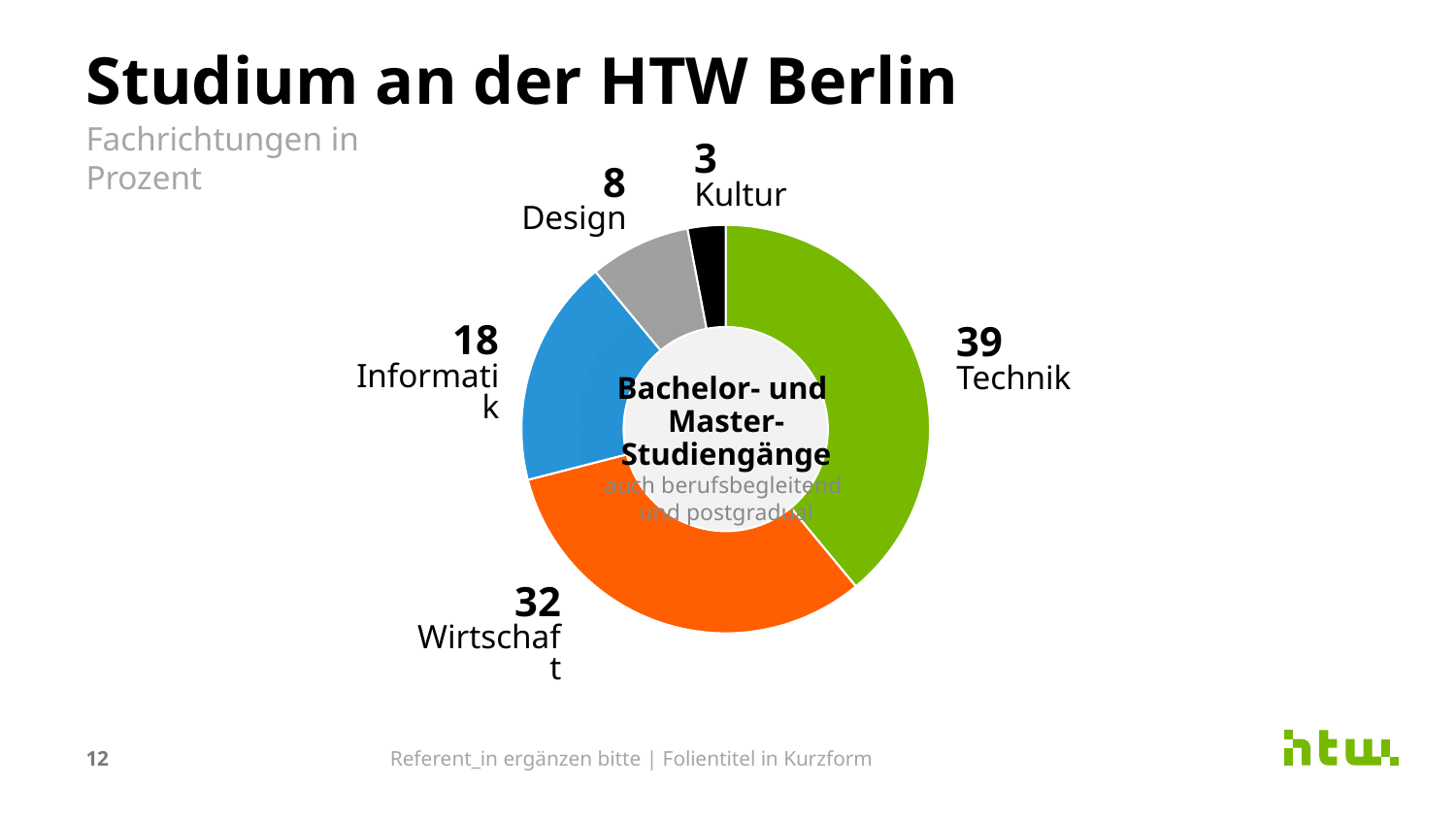
Which category has the largest share of the chart? Technik What value is shown for Informatik? 18 What value is shown for Technik? 39 What value is shown for Kultur? 3 Which is larger, the value for Wirtschaft or the value for Informatik? Wirtschaft What kind of chart is shown on the slide? Doughnut chart How many categories are shown in the chart? 5 What is the difference between the values for Technik and Wirtschaft? 7 Which category has the smallest share of the chart? Kultur What text is written in the centre of the doughnut chart in bold? Bachelor- und Master-Studiengänge What is the difference between the values for Informatik and Design? 10 What value is shown for Wirtschaft? 32